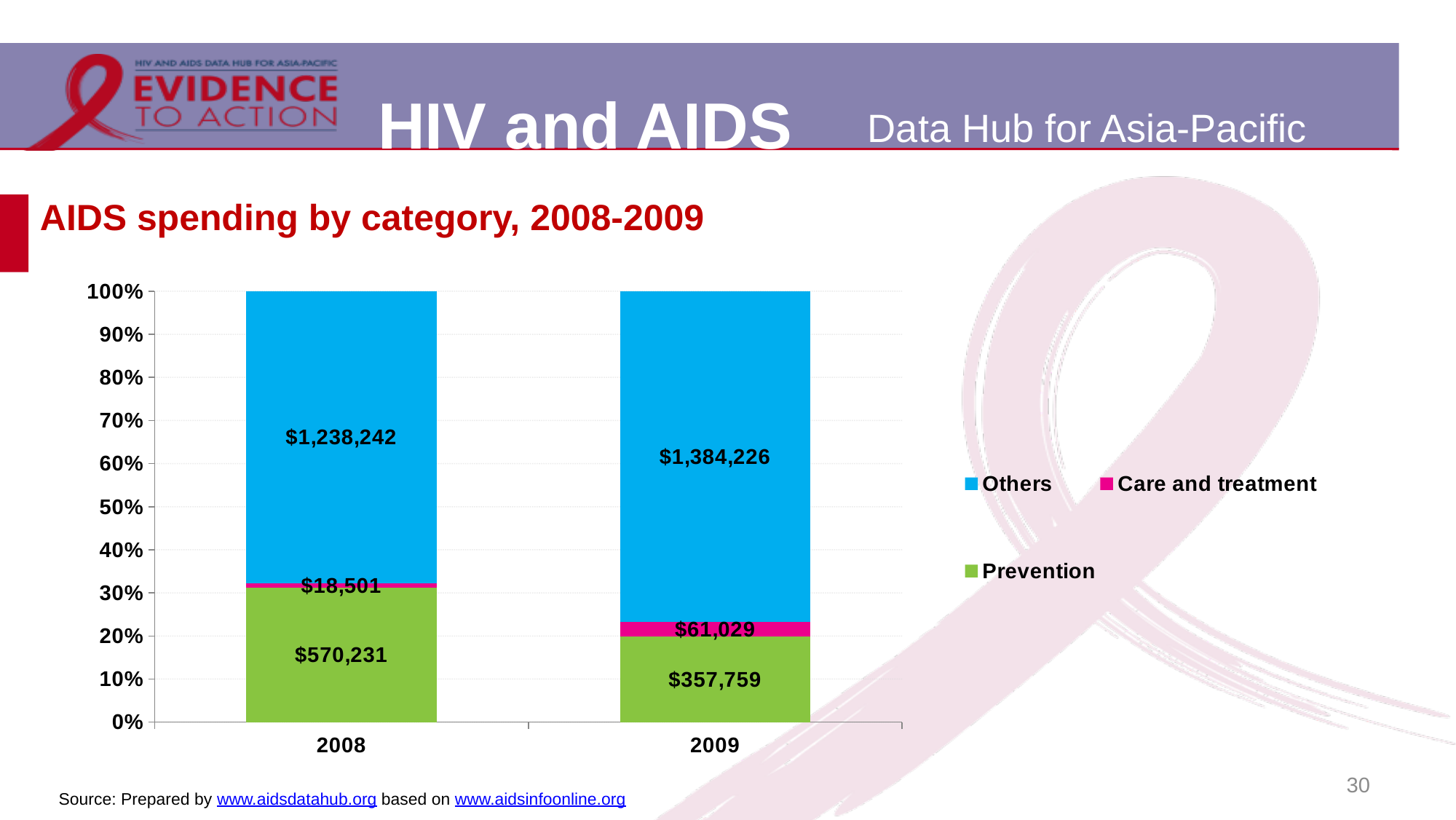
What was the spending on Care and treatment in 2009? $61,029 By how much did spending on Others increase from 2008 to 2009? $145,984 What is the title of the chart? AIDS spending by category, 2008-2009 What type of chart is shown on the slide? Stacked bar chart What was the spending on Others in 2009? $1,384,226 Was spending on Prevention higher in 2008 or in 2009? 2008 Which category had the highest spending in 2009? Others Which category had the lowest spending in 2008? Care and treatment What was the total AIDS spending across all three categories in 2008? $1,826,974 How many years are shown on the x axis? 2 How many series does the legend list? 3 What was the spending on Prevention in 2008? $570,231